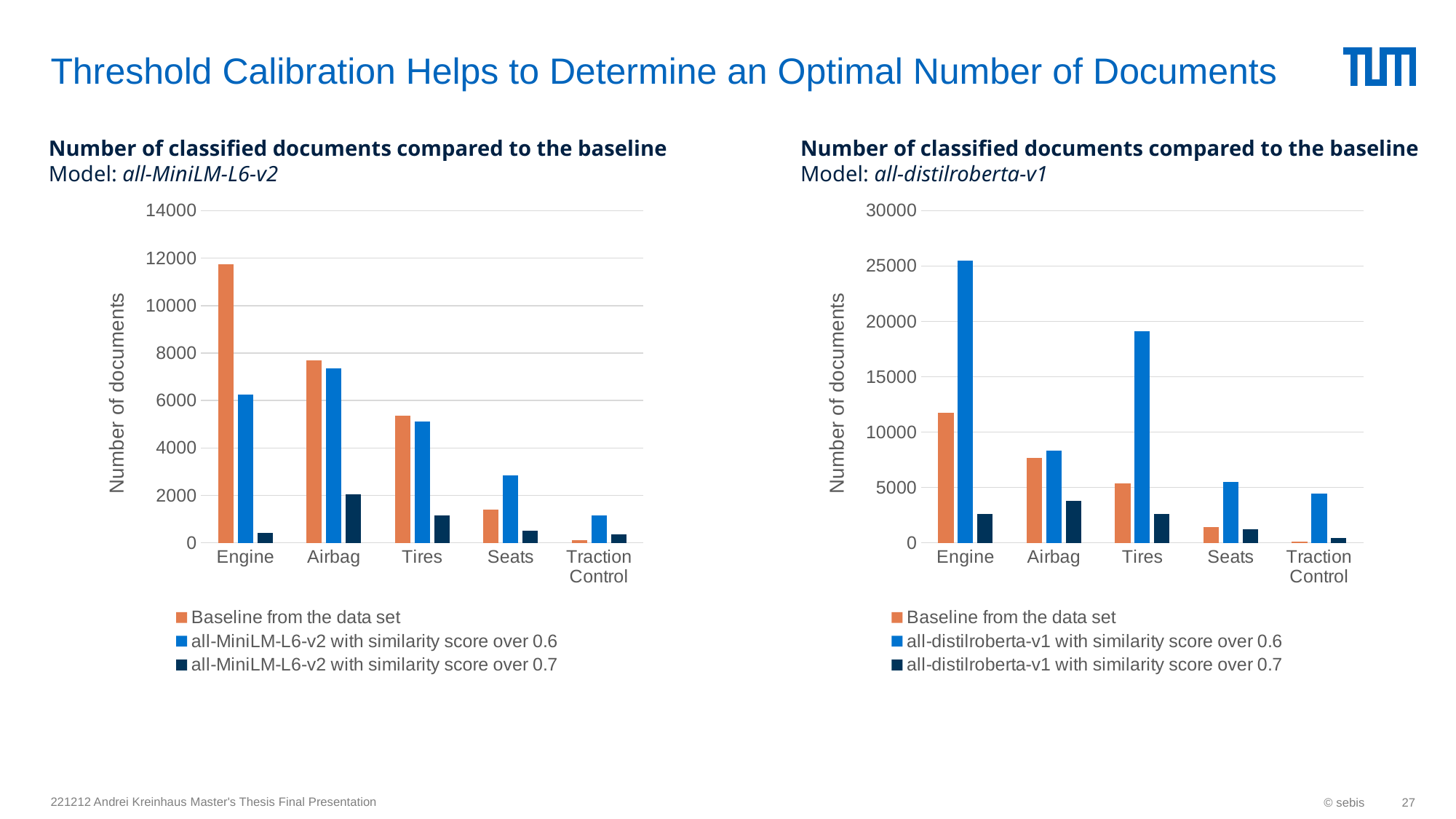
In the left chart (Model: all-MiniLM-L6-v2), is the value for Engine in the 'all-MiniLM-L6-v2 with similarity score over 0.6' series greater or less than 8000? less In the left chart (Model: all-MiniLM-L6-v2), which category has the highest value for 'Baseline from the data set'? Engine In the right chart (Model: all-distilroberta-v1), which category has the lowest value for 'Baseline from the data set'? Traction Control In the left chart (Model: all-MiniLM-L6-v2), how many categories are shown on the x axis? 5 In the left chart (Model: all-MiniLM-L6-v2), do the 'Baseline from the data set' values rise or fall from Engine to Traction Control? fall In the left chart (Model: all-MiniLM-L6-v2), for Engine, which is larger: 'Baseline from the data set' or 'all-MiniLM-L6-v2 with similarity score over 0.6'? Baseline from the data set In the left chart (Model: all-MiniLM-L6-v2), how many series does the legend list? 3 In the right chart (Model: all-distilroberta-v1), which category has the highest value for 'all-distilroberta-v1 with similarity score over 0.6'? Engine In the left chart (Model: all-MiniLM-L6-v2), what kind of chart is shown? bar chart In the left chart (Model: all-MiniLM-L6-v2), is the 'Baseline from the data set' value for Engine greater or less than 10000? greater In the right chart (Model: all-distilroberta-v1), what is the label of the y axis? Number of documents In the right chart (Model: all-distilroberta-v1), is the value for Engine in the 'all-distilroberta-v1 with similarity score over 0.6' series greater or less than 20000? greater